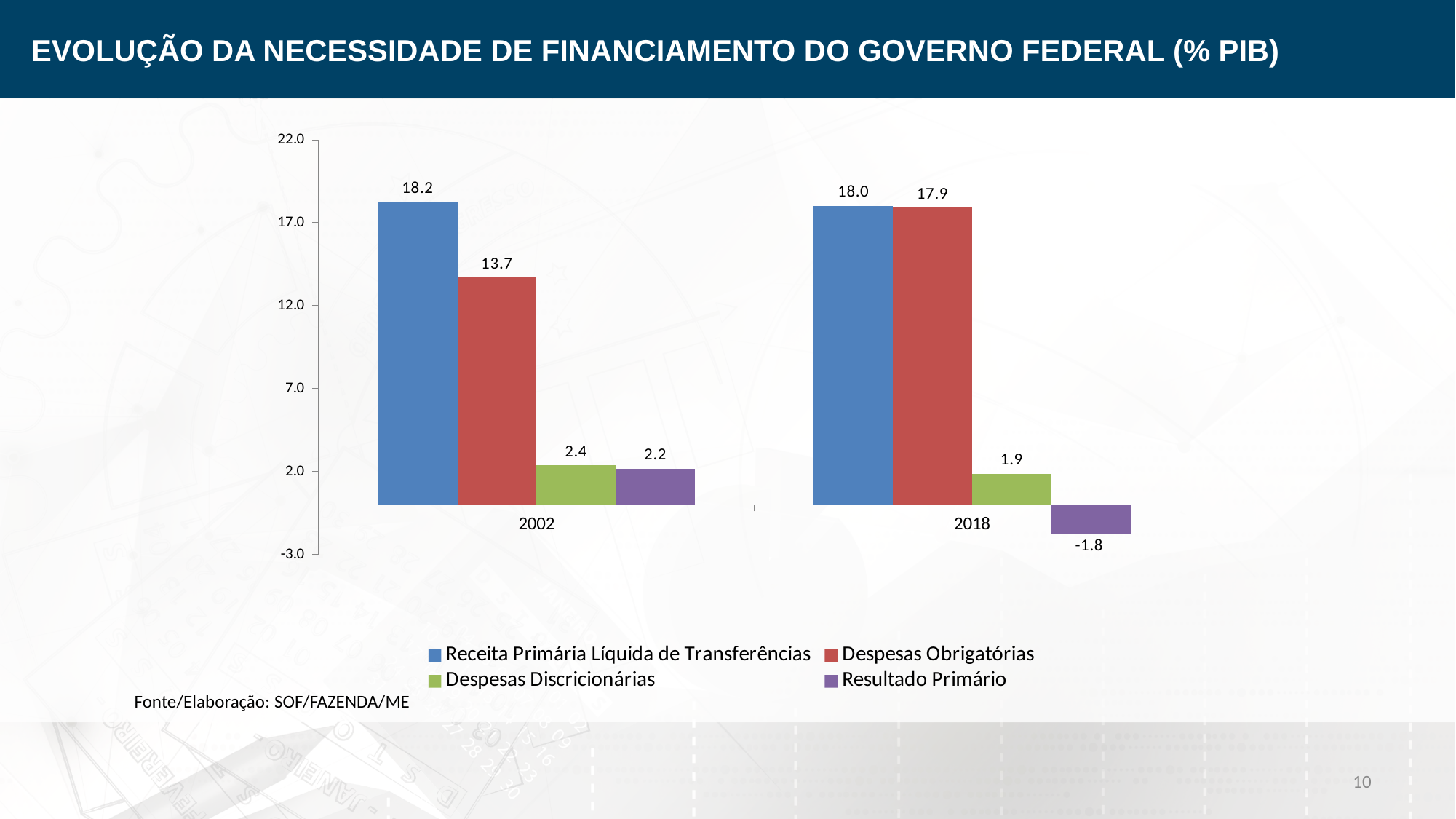
What kind of chart is shown on the slide? Bar chart What is the value of Despesas Obrigatórias in 2018? 17.9 What is the difference between Despesas Obrigatórias in 2018 and in 2002? 4.2 Which series has the lowest value in 2018? Resultado Primário What is the value of Receita Primária Líquida de Transferências in 2002? 18.2 How many categories are shown on the x axis? 2 How many series does the legend list? 4 Which series has the highest value in 2002? Receita Primária Líquida de Transferências What is the value of Despesas Discricionárias in 2002? 2.4 Which is larger: Despesas Discricionárias in 2002 or in 2018? 2002 What is the value of Resultado Primário in 2018? -1.8 What is the source cited below the chart? SOF/FAZENDA/ME